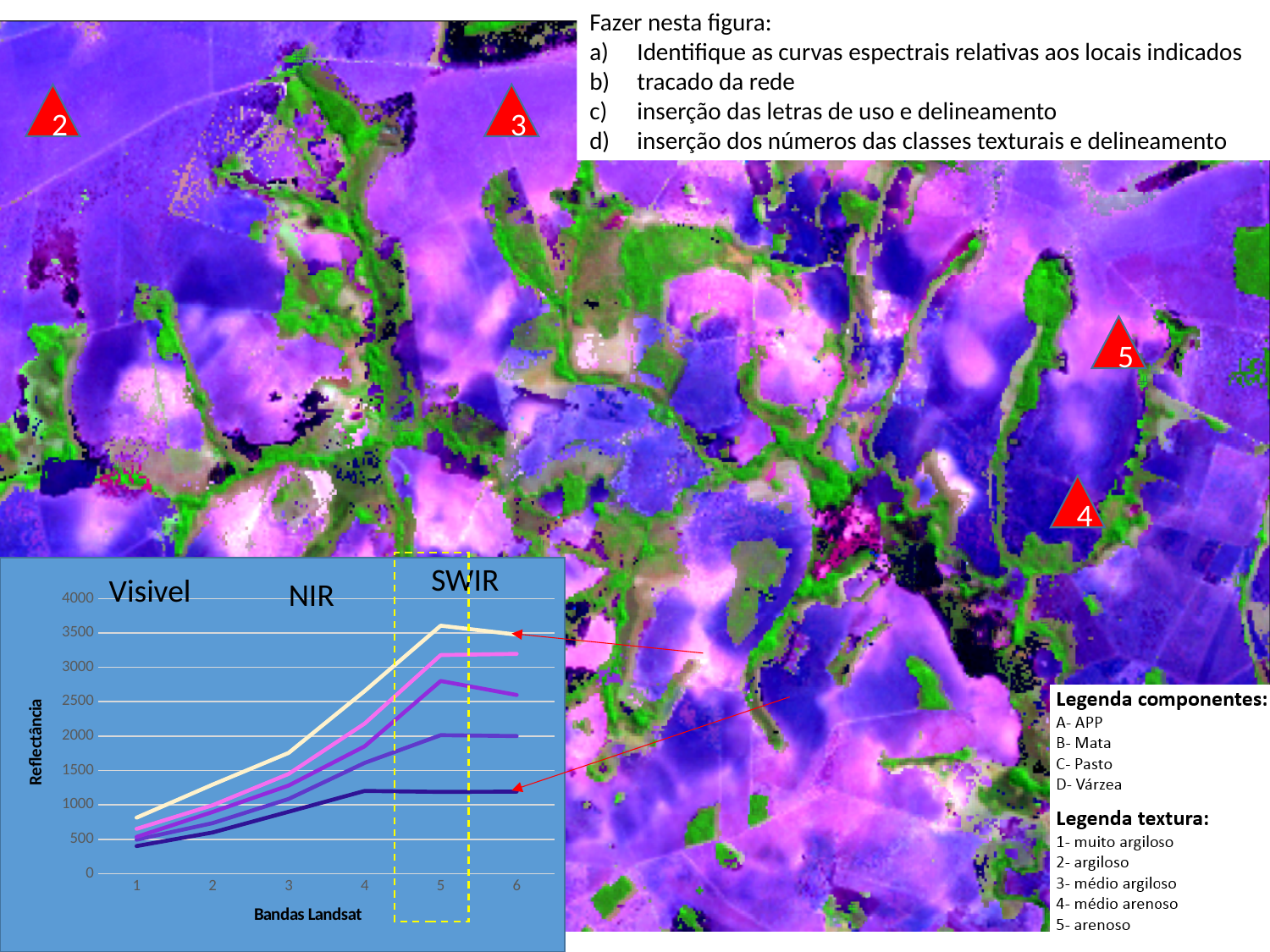
What kind of chart is shown in the lower-left corner of the slide? line chart Is the value of the purple line at band 6 greater or less than 3000? less Do the reflectance values of the lines rise or fall from band 1 to band 5? rise At band 1, is the cream/white line higher or lower than the dark navy line? higher What is the title of the y axis of the chart? Reflectância What is the title of the x axis of the chart? Bandas Landsat Is the value of the cream/white line at band 5 greater or less than 3000? greater How many lines are plotted in the chart? 5 Which line has the highest reflectance at band 5? the cream/white line Is the value of the dark navy line at band 5 greater or less than 1500? less Which line has the lowest reflectance at band 5? the dark navy line How many Landsat bands are plotted along the x axis of the chart? 6